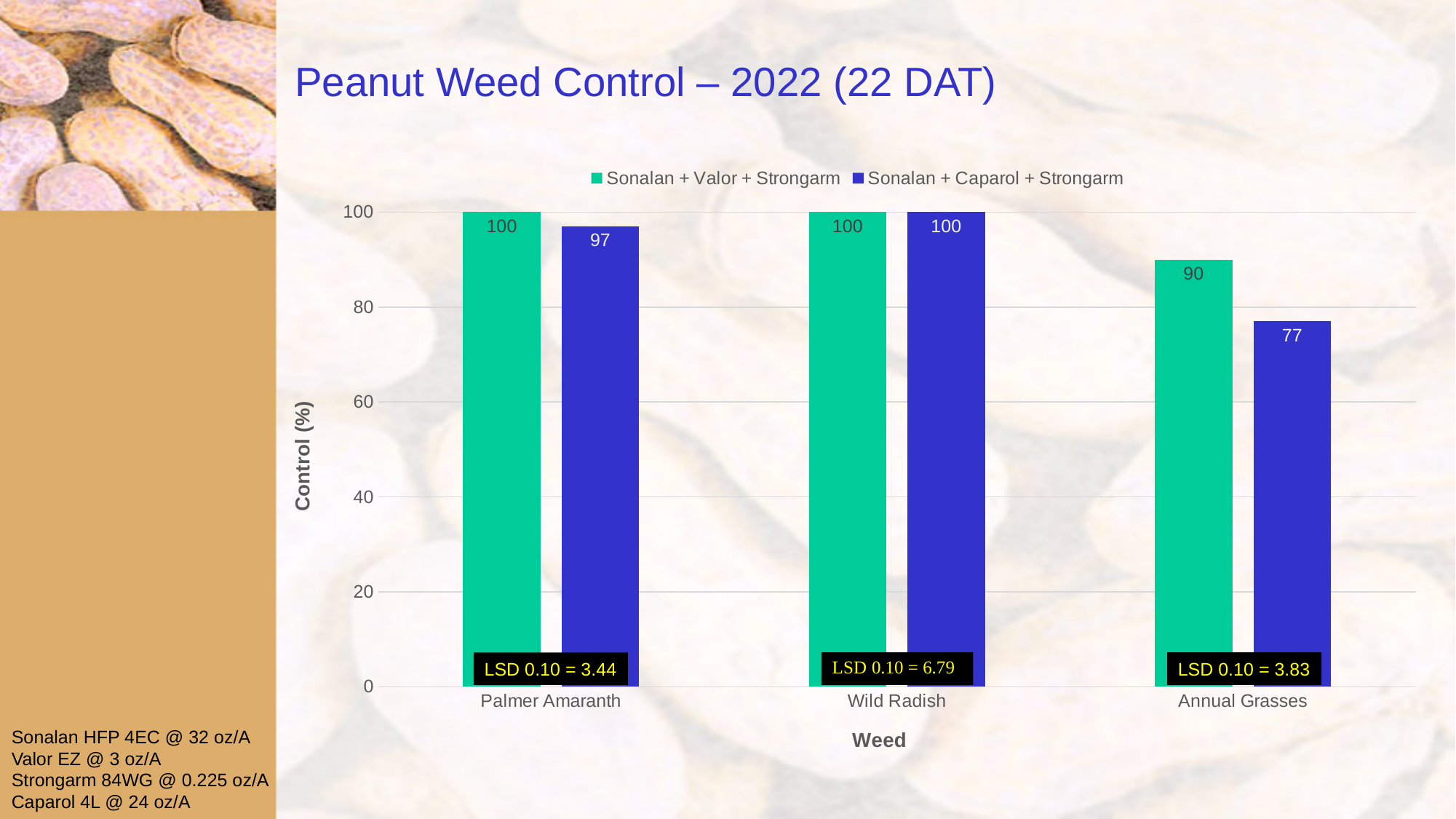
What kind of chart is shown on the slide? bar chart How many series does the legend list? 2 Which weed has the lowest control value for Sonalan + Valor + Strongarm? Annual Grasses How many weed categories are shown on the x axis? 3 Is the value for Sonalan + Caparol + Strongarm on Annual Grasses greater or less than 80? less What is the control value for Sonalan + Caparol + Strongarm on Annual Grasses? 77 What is the title of the chart on the slide? Peanut Weed Control – 2022 (22 DAT) Which treatment has the higher control value on Palmer Amaranth? Sonalan + Valor + Strongarm Which weed has the lowest control value for Sonalan + Caparol + Strongarm? Annual Grasses What is the difference between the two treatments' control values on Annual Grasses? 13 What is the control value for Sonalan + Caparol + Strongarm on Palmer Amaranth? 97 What is the control value for Sonalan + Valor + Strongarm on Palmer Amaranth? 100